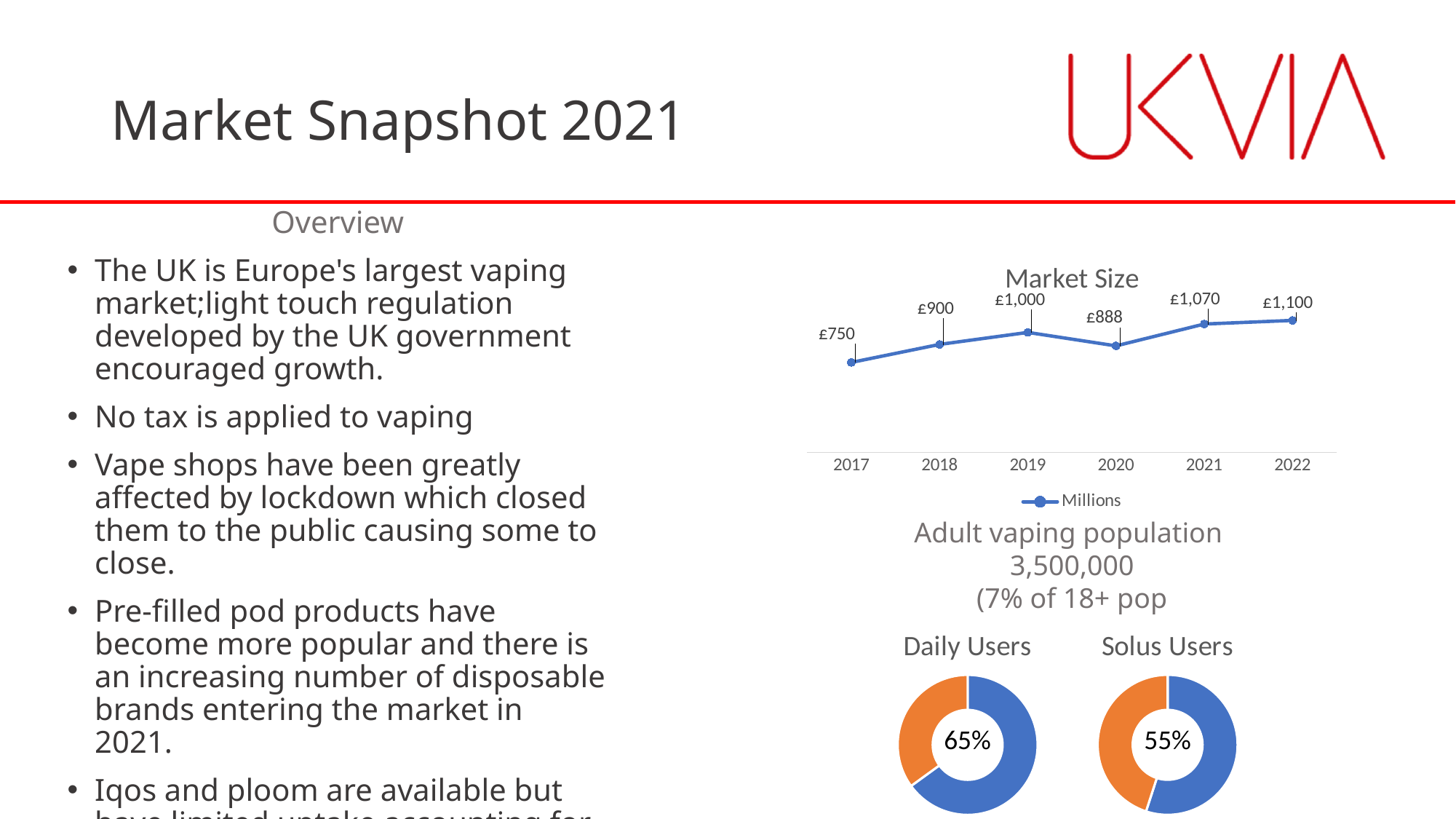
In the Daily Users doughnut chart, what percentage is shown in the centre? 65% In the Solus Users doughnut chart, what percentage is shown in the centre? 55% In the Market Size chart, what is the value for 2017? £750 In the Market Size chart, which is larger, the value for 2019 or the value for 2020? 2019 In the Market Size chart, which year has the lowest value? 2017 In the Market Size chart, which year has the highest value? 2022 In the Market Size chart, what is the value for 2022? £1,100 What kind of chart is the Market Size chart? line chart How many years are plotted in the Market Size chart? 6 In the Market Size chart, what is the value for 2020? £888 In the Market Size chart, what is the difference between the values for 2021 and 2020? £182 In the Market Size chart, what is the legend entry for the plotted series? Millions